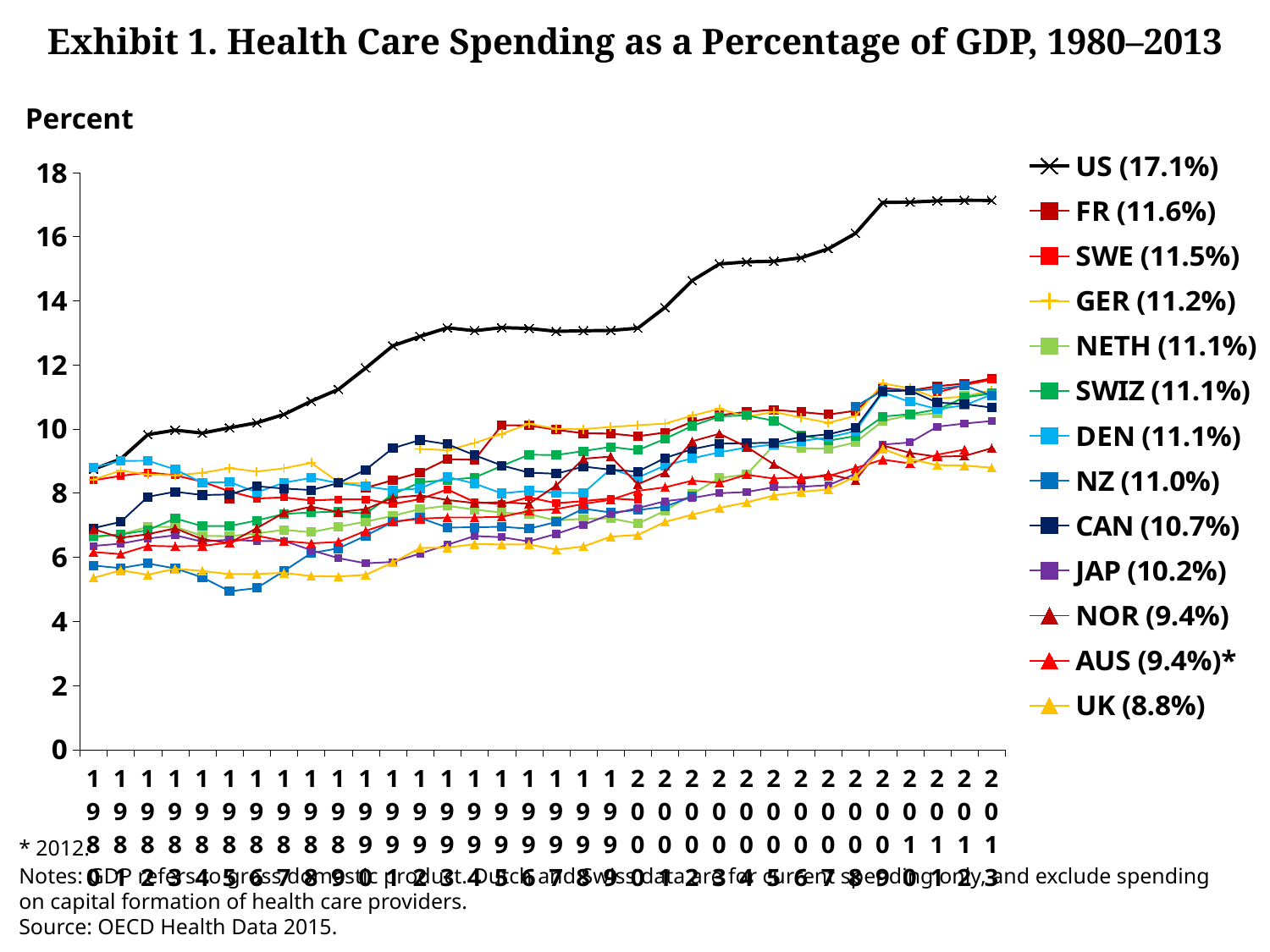
Is the value for UK in 1980 greater or less than 6? less What value is shown for UK in the legend? 8.8% What is the difference between the legend values for US and FR? 5.5 Which country has the highest value in the legend? US What kind of chart is shown on the slide? line chart Which has the larger legend value, FR or SWE? FR What value is shown for US in the legend? 17.1% How many series does the legend list? 13 Which country has the lowest value in the legend? UK Is the value for US in 2000 greater or less than 12? greater Does the US line rise or fall from 1980 to 2013? rise What value is shown for CAN in the legend? 10.7%